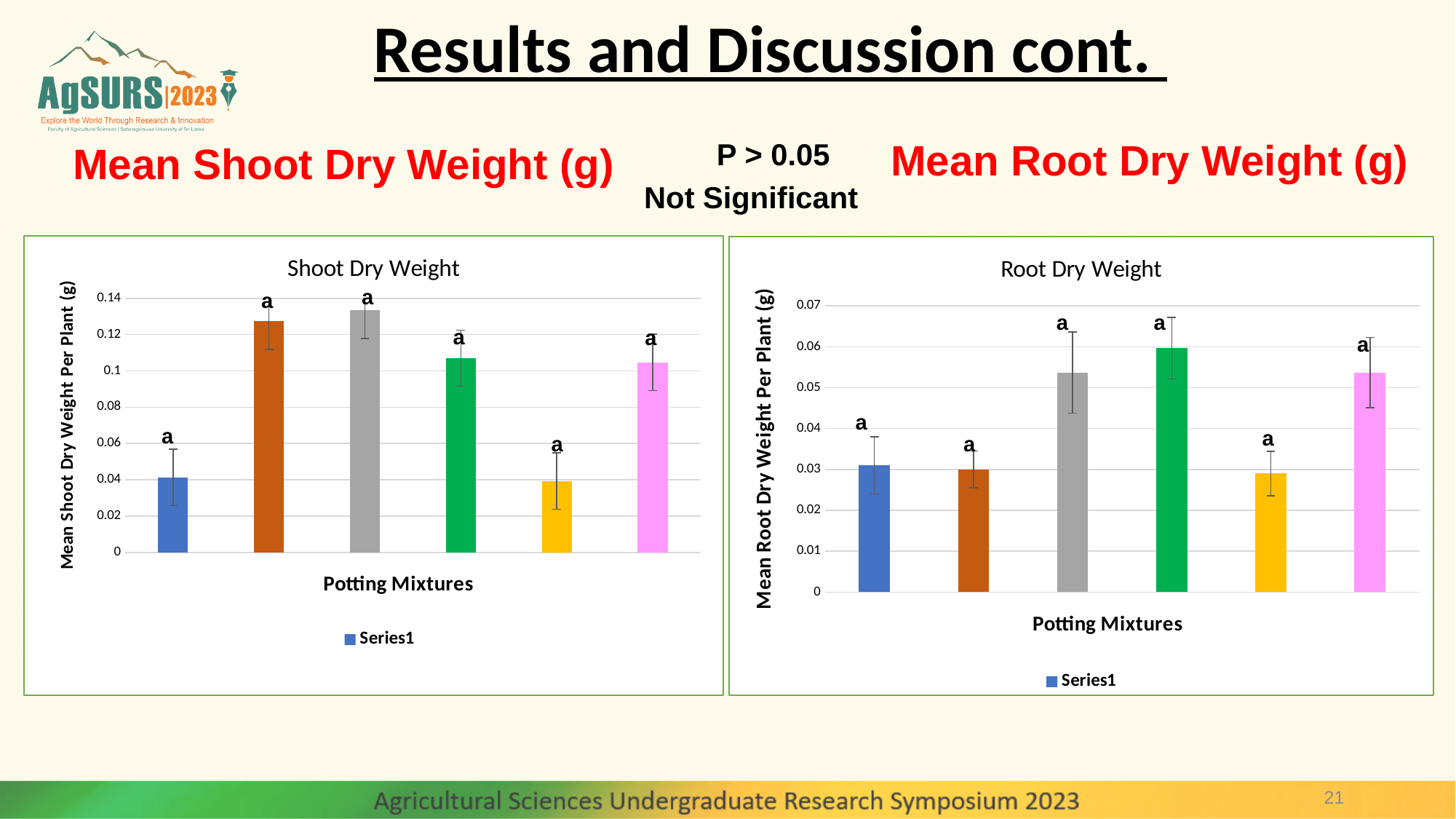
In the Root Dry Weight chart, how many series does the legend list? 1 In the Shoot Dry Weight chart, is the value of the blue bar greater or less than 0.06? less In the Shoot Dry Weight chart, how many bars are plotted? 6 In the Root Dry Weight chart, which bar (by colour) is the tallest? green In the Shoot Dry Weight chart, which bar (by colour) is the tallest? gray What is the x-axis title of the Root Dry Weight chart? Potting Mixtures What kind of chart is the Shoot Dry Weight chart on the left? bar chart In the Root Dry Weight chart, which is larger, the green bar or the yellow bar? green bar In the Root Dry Weight chart, is the value of the orange bar greater or less than 0.04? less In the Shoot Dry Weight chart, is the value of the orange bar greater or less than 0.12? greater In the Shoot Dry Weight chart, which is larger, the orange bar or the blue bar? orange bar